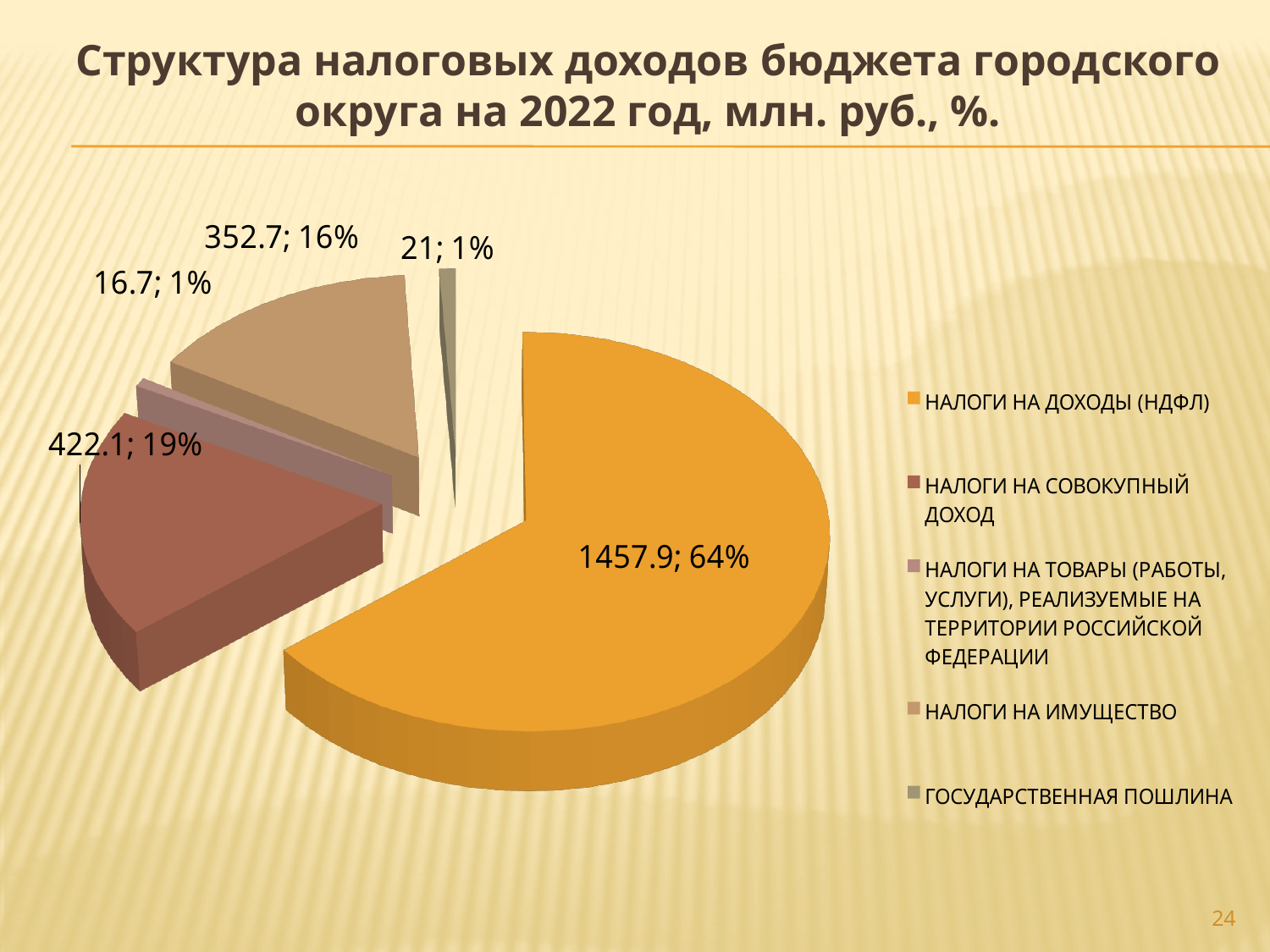
What is the difference in million rubles between НАЛОГИ НА СОВОКУПНЫЙ ДОХОД and НАЛОГИ НА ИМУЩЕСТВО? 69.4 What share of the pie does НАЛОГИ НА ТОВАРЫ (РАБОТЫ, УСЛУГИ), РЕАЛИЗУЕМЫЕ НА ТЕРРИТОРИИ РОССИЙСКОЙ ФЕДЕРАЦИИ represent? 1% What is the title of the chart on the slide? Структура налоговых доходов бюджета городского округа на 2022 год, млн. руб., %. Which category has the largest slice of the pie? НАЛОГИ НА ДОХОДЫ (НДФЛ) What is the value shown for НАЛОГИ НА ИМУЩЕСТВО? 352.7; 16% What is the value shown for ГОСУДАРСТВЕННАЯ ПОШЛИНА? 21; 1% How many slices does the pie chart have? 5 Which category has the smallest value in the pie? НАЛОГИ НА ТОВАРЫ (РАБОТЫ, УСЛУГИ), РЕАЛИЗУЕМЫЕ НА ТЕРРИТОРИИ РОССИЙСКОЙ ФЕДЕРАЦИИ What is the value shown for НАЛОГИ НА СОВОКУПНЫЙ ДОХОД? 422.1; 19% Which is larger, НАЛОГИ НА СОВОКУПНЫЙ ДОХОД or НАЛОГИ НА ИМУЩЕСТВО? НАЛОГИ НА СОВОКУПНЫЙ ДОХОД What kind of chart is shown on the slide? pie chart What is the value shown for НАЛОГИ НА ДОХОДЫ (НДФЛ)? 1457.9; 64%